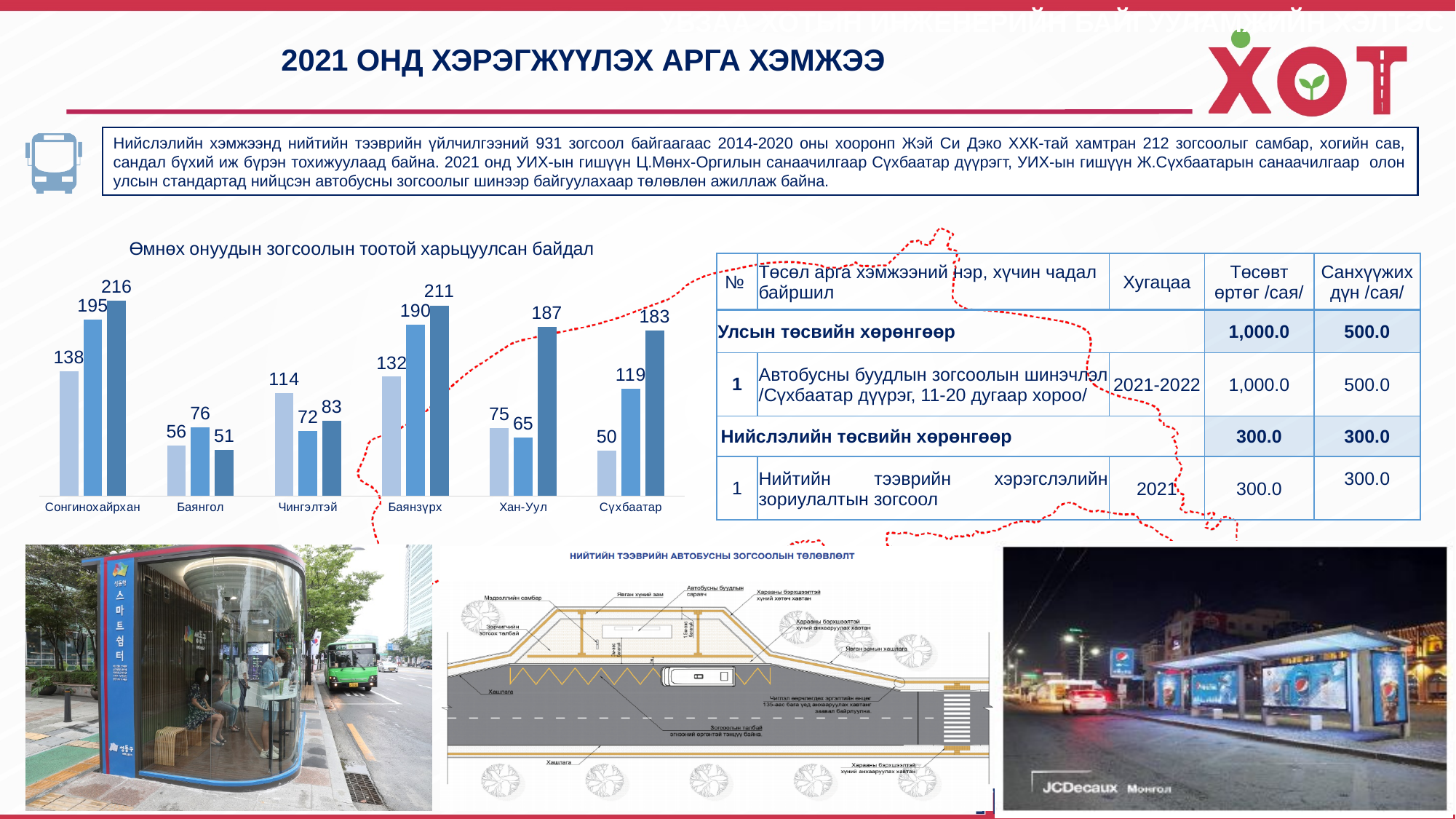
In the bar chart, what is the value of the dark blue (third) bar for Сонгинохайрхан? 216 In the bar chart, what is the difference between the dark blue bars of Сонгинохайрхан and Баянзүрх? 5 In the bar chart, which is larger for Баянгол: the medium blue (second) bar or the dark blue (third) bar? the medium blue (second) bar Which district has the lowest light blue (first) bar in the bar chart? Сүхбаатар In the bar chart, what is the value of the dark blue (third) bar for Хан-Уул? 187 In the bar chart, what is the value of the light blue (first) bar for Баянзүрх? 132 How many categories (districts) are shown on the x axis of the bar chart? 6 What type of chart is shown under the title 'Өмнөх онуудын зогсоолын тоотой харьцуулсан байдал'? bar chart In the bar chart, what is the value of the medium blue (second) bar for Сүхбаатар? 119 Which district has the highest dark blue (third) bar in the bar chart? Сонгинохайрхан In the bar chart, what is the difference between the dark blue bar and the light blue bar for Сүхбаатар? 133 How many bars are shown for each district in the bar chart? 3